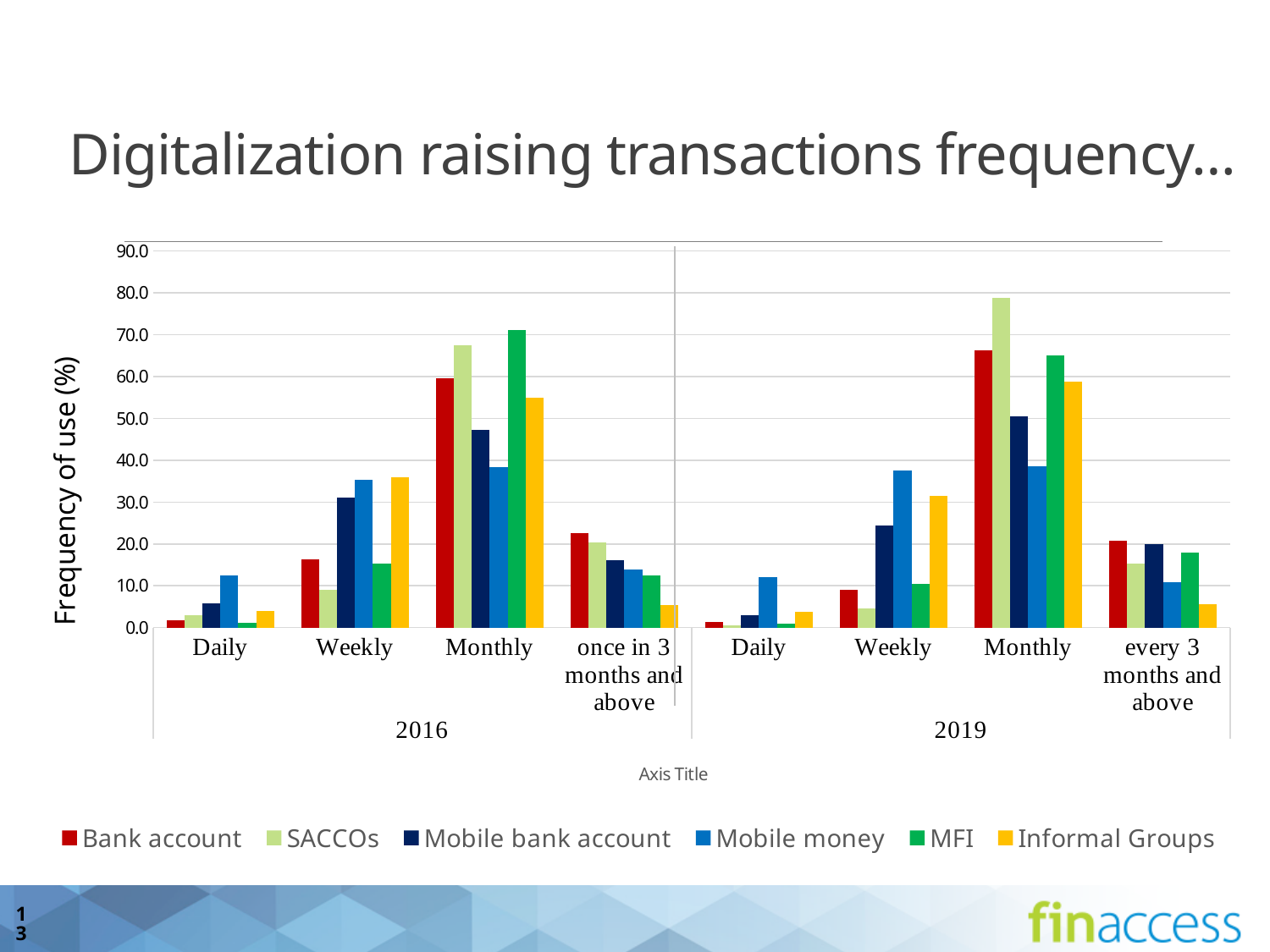
In the 2019 Daily group, which series has the highest value? Mobile money How many frequency categories are shown for each year on the x axis? 4 Is the value for Bank account in the 2019 Monthly group greater or less than 60? greater In the 2016 'once in 3 months and above' group, which series has the lowest value? Informal Groups In the 2019 Monthly group, which series has the highest value? SACCOs What kind of chart is shown on the slide? Bar chart Is the value for SACCOs in the 2019 Monthly group greater or less than 70? greater What is the title of the vertical axis? Frequency of use (%) How many series does the legend list? 6 In the 2016 Monthly group, which series has the highest value? MFI Is the value for Mobile money in the 2016 Daily group greater or less than 10? greater In the 2016 Weekly group, which is larger: Mobile money or Bank account? Mobile money